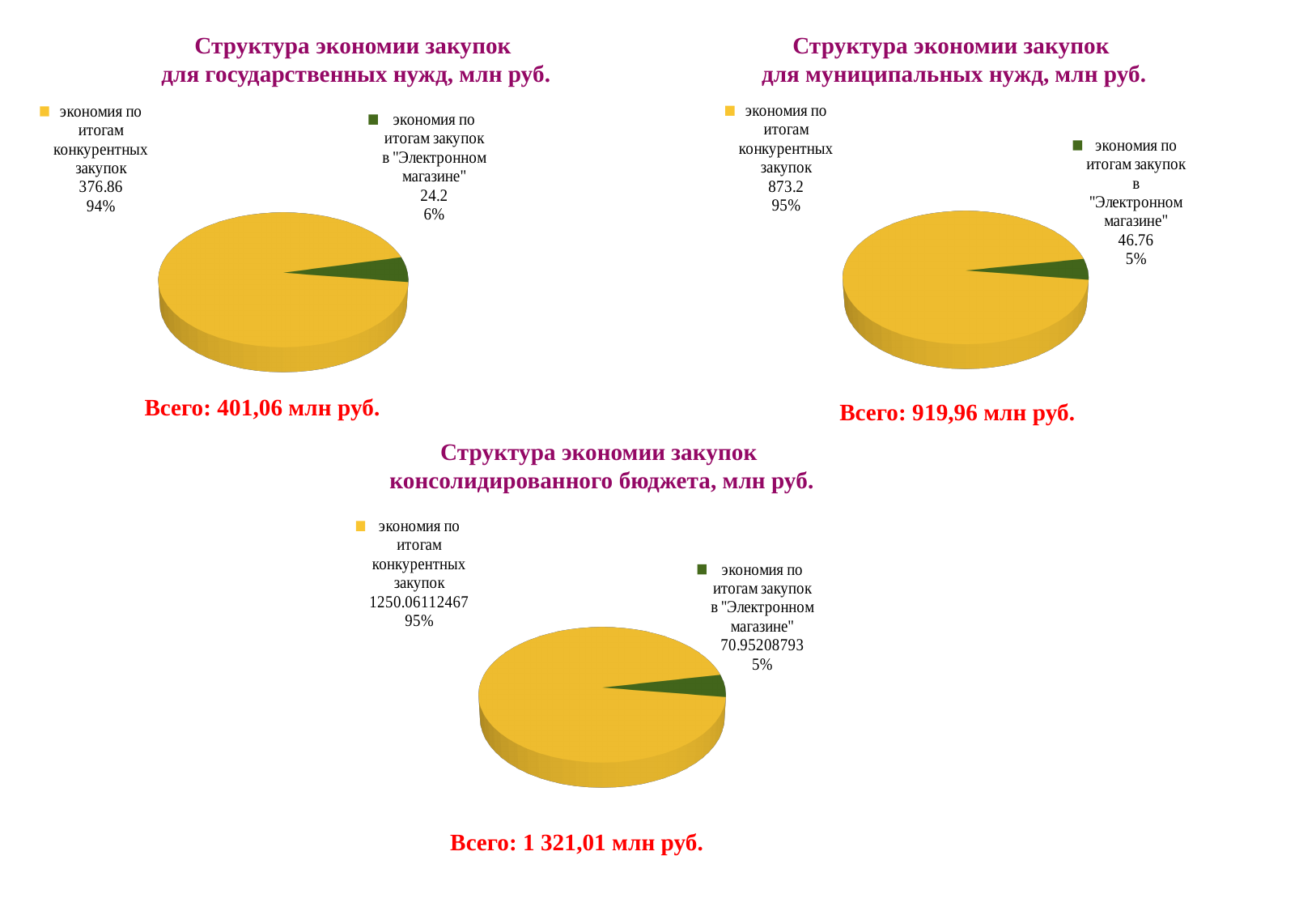
How many slices does the top-right chart (для муниципальных нужд) have? 2 What type of chart is the bottom chart (консолидированного бюджета)? pie chart What total (Всего) is stated below the bottom chart (консолидированного бюджета)? 1 321,01 млн руб. In the bottom chart (консолидированного бюджета), what is the value for экономия по итогам закупок в "Электронном магазине"? 70.95208793 In the top-right chart (для муниципальных нужд), what is the value for экономия по итогам закупок в "Электронном магазине"? 46.76 In the top-left chart (для государственных нужд), what share of the pie does экономия по итогам закупок в "Электронном магазине" take? 6% In the top-right chart (для муниципальных нужд), what share of the pie does экономия по итогам конкурентных закупок take? 95% In the bottom chart (консолидированного бюджета), which category is the largest? экономия по итогам конкурентных закупок In the top-left chart (для государственных нужд), which category is the smallest? экономия по итогам закупок в "Электронном магазине" In the top-left chart (Структура экономии закупок для государственных нужд), what is the value for экономия по итогам конкурентных закупок? 376.86 In the top-left chart (для государственных нужд), what is the value for экономия по итогам закупок в "Электронном магазине"? 24.2 In the top-right chart (для муниципальных нужд), what is the value for экономия по итогам конкурентных закупок? 873.2